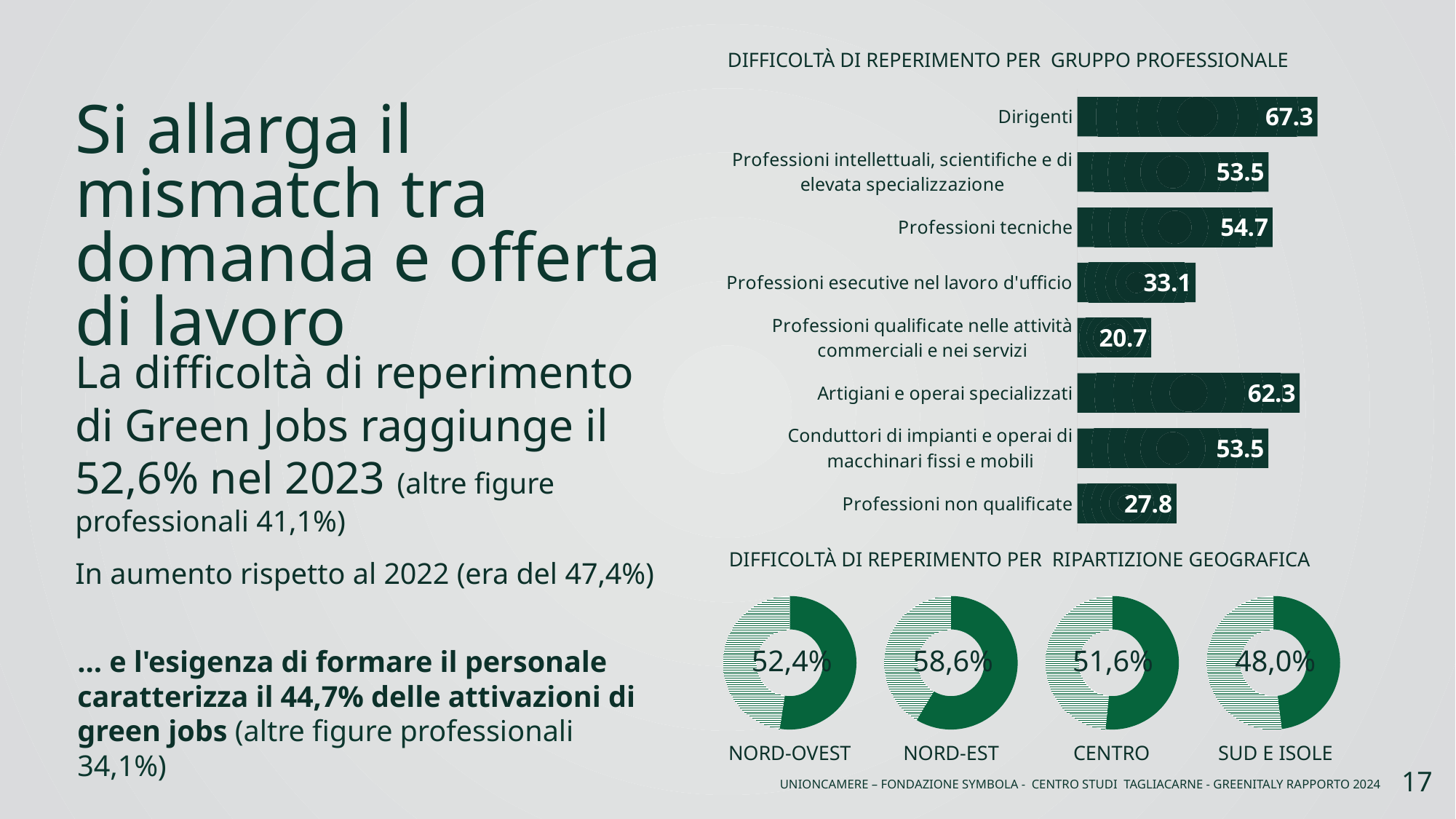
How many geographic areas are shown in the charts 'Difficoltà di reperimento per ripartizione geografica'? 4 In the charts 'Difficoltà di reperimento per ripartizione geografica', what is the value for Nord-Est? 58,6% In the chart 'Difficoltà di reperimento per gruppo professionale', what is the value for Professioni tecniche? 54.7 In the chart 'Difficoltà di reperimento per gruppo professionale', what is the value for Dirigenti? 67.3 How many professional groups are shown in the chart 'Difficoltà di reperimento per gruppo professionale'? 8 In the chart 'Difficoltà di reperimento per gruppo professionale', what is the value for Professioni non qualificate? 27.8 In the chart 'Difficoltà di reperimento per gruppo professionale', which professional group has the lowest value? Professioni qualificate nelle attività commerciali e nei servizi In the chart 'Difficoltà di reperimento per gruppo professionale', what is the difference between the values for Dirigenti and Artigiani e operai specializzati? 5 In the chart 'Difficoltà di reperimento per gruppo professionale', which is larger: the value for Professioni esecutive nel lavoro d'ufficio or the value for Professioni non qualificate? Professioni esecutive nel lavoro d'ufficio In the charts 'Difficoltà di reperimento per ripartizione geografica', which geographic area has the lowest value? Sud e Isole In the chart 'Difficoltà di reperimento per gruppo professionale', which professional group has the highest value? Dirigenti What type of chart is 'Difficoltà di reperimento per gruppo professionale'? Bar chart